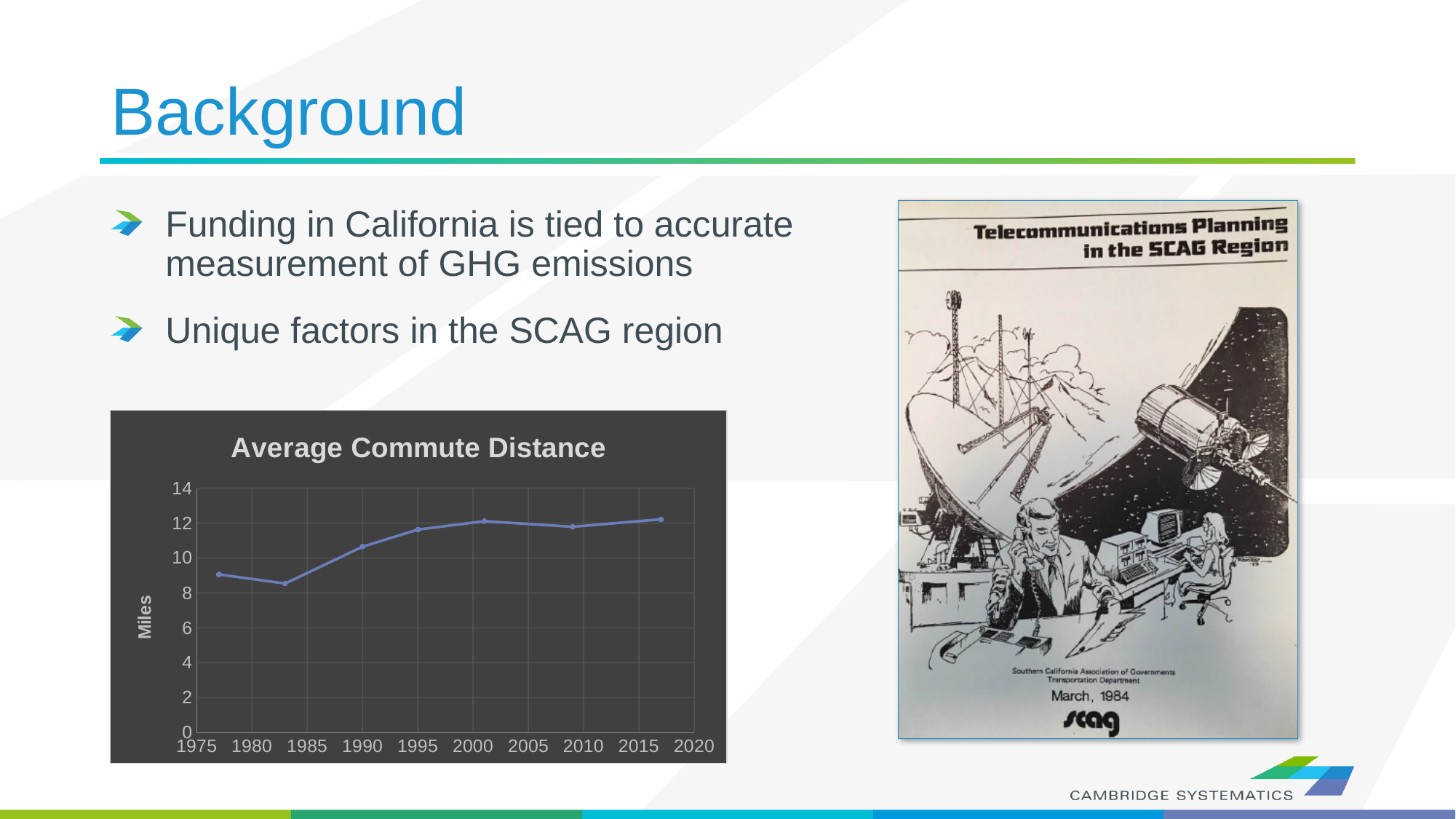
What is the highest value shown on the vertical axis of the Average Commute Distance chart? 14 Which plotted point on the Average Commute Distance chart has the lowest value: the one around 1983 or the one around 1990? the one around 1983 What is the title of the chart on the slide? Average Commute Distance Overall, does the average commute distance rise or fall from the first point to the last point on the chart? rise How many data points are plotted on the Average Commute Distance line? 7 What kind of chart is the Average Commute Distance chart? line chart What is the label on the vertical axis of the Average Commute Distance chart? Miles Is the value plotted around 1995 on the Average Commute Distance chart greater or less than 12 miles? less Is the value plotted around 1983 on the Average Commute Distance chart greater or less than 10 miles? less Is the value plotted around 1990 on the Average Commute Distance chart greater or less than 10 miles? greater Which point on the Average Commute Distance chart is the lowest? the second point, around 1983